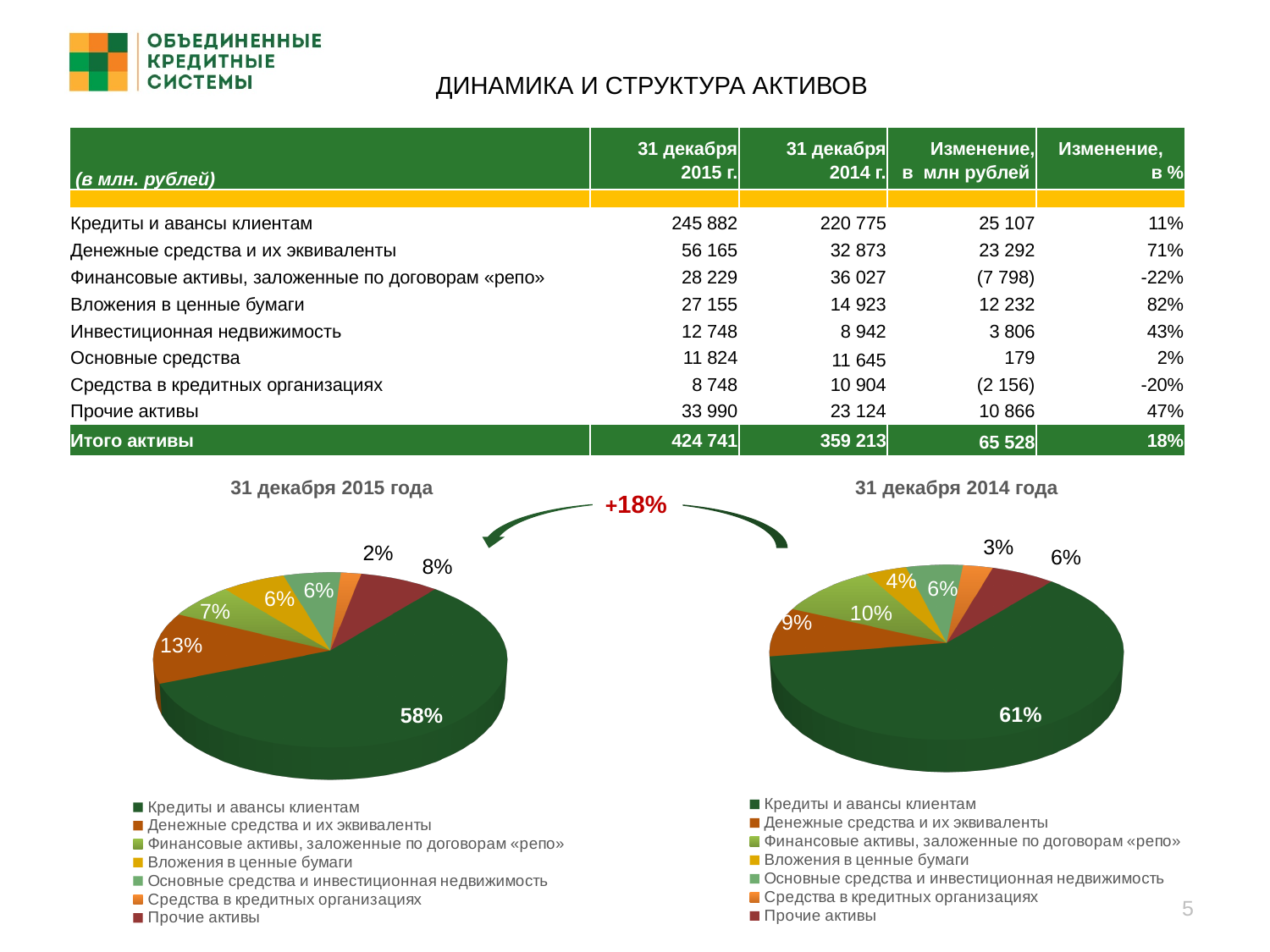
In the pie chart titled "31 декабря 2014 года", what share is shown for Кредиты и авансы клиентам? 61% In the pie chart titled "31 декабря 2015 года", which category has the smallest slice? Средства в кредитных организациях In the pie chart titled "31 декабря 2015 года", what share is shown for Кредиты и авансы клиентам? 58% In the pie chart titled "31 декабря 2015 года", what share is shown for Денежные средства и их эквиваленты? 13% What percentage change is written on the arrow between the two pie charts? +18% In the pie chart titled "31 декабря 2014 года", which category has the largest slice? Кредиты и авансы клиентам How many categories does the legend of the "31 декабря 2014 года" chart list? 7 What type of chart is used for "31 декабря 2015 года"? Pie chart Which is larger: the share of Денежные средства и их эквиваленты in the "31 декабря 2015 года" chart or in the "31 декабря 2014 года" chart? 31 декабря 2015 года